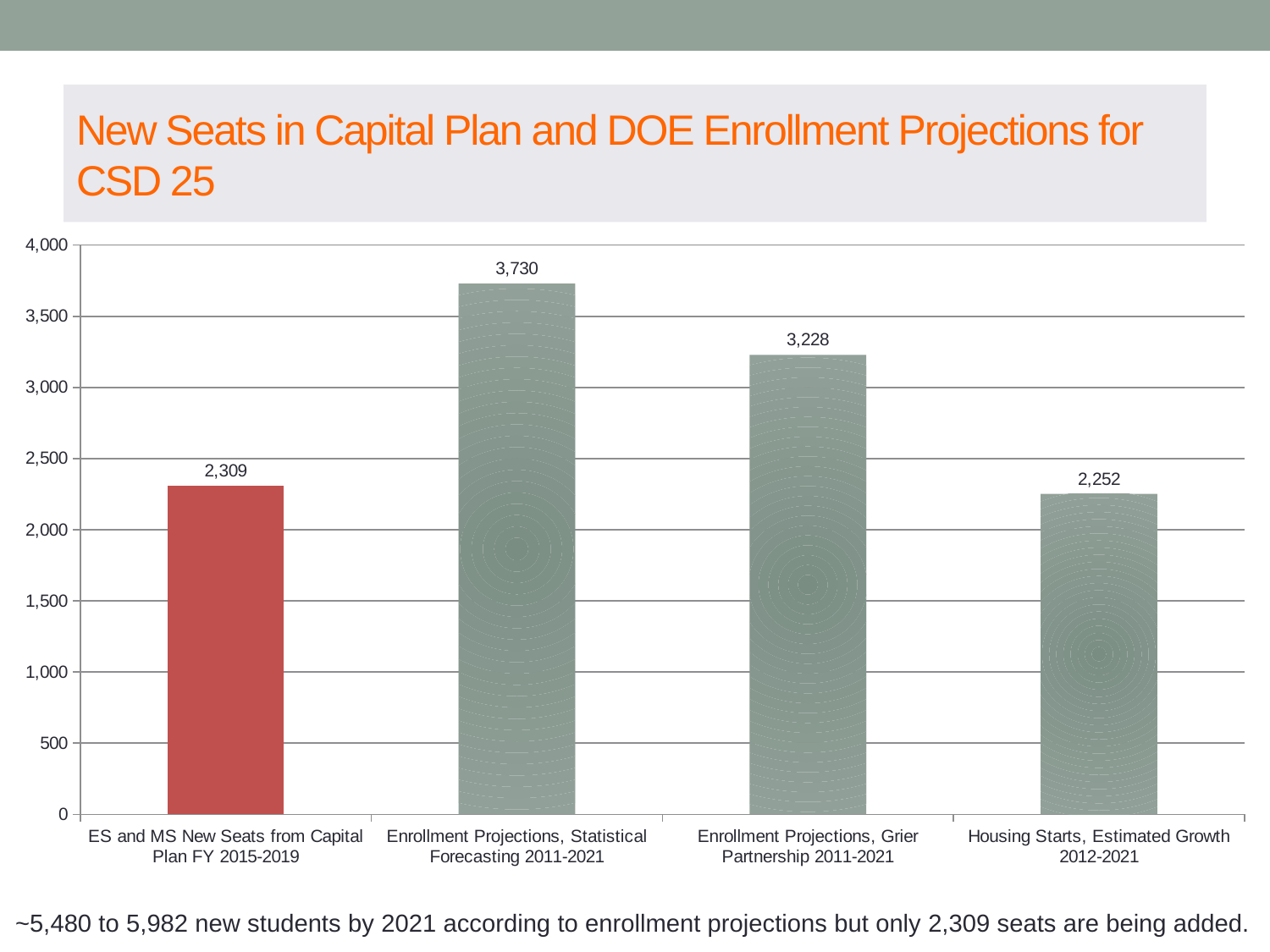
What is the value for Enrollment Projections, Statistical Forecasting 2011-2021? 3,730 How many categories are shown in the chart? 4 What is the difference between the Grier Partnership projection and the ES and MS New Seats from the Capital Plan? 919 Which bar is shown in a different colour (red) from the others? ES and MS New Seats from Capital Plan FY 2015-2019 What is the value for Enrollment Projections, Grier Partnership 2011-2021? 3,228 What is the value for Housing Starts, Estimated Growth 2012-2021? 2,252 Which category has the highest value? Enrollment Projections, Statistical Forecasting 2011-2021 Which category has the lowest value? Housing Starts, Estimated Growth 2012-2021 What is the value for ES and MS New Seats from Capital Plan FY 2015-2019? 2,309 Which is larger: ES and MS New Seats from Capital Plan FY 2015-2019 or Housing Starts, Estimated Growth 2012-2021? ES and MS New Seats from Capital Plan FY 2015-2019 What is the difference between the Statistical Forecasting projection and the Grier Partnership projection? 502 What kind of chart is shown on the slide? Bar chart